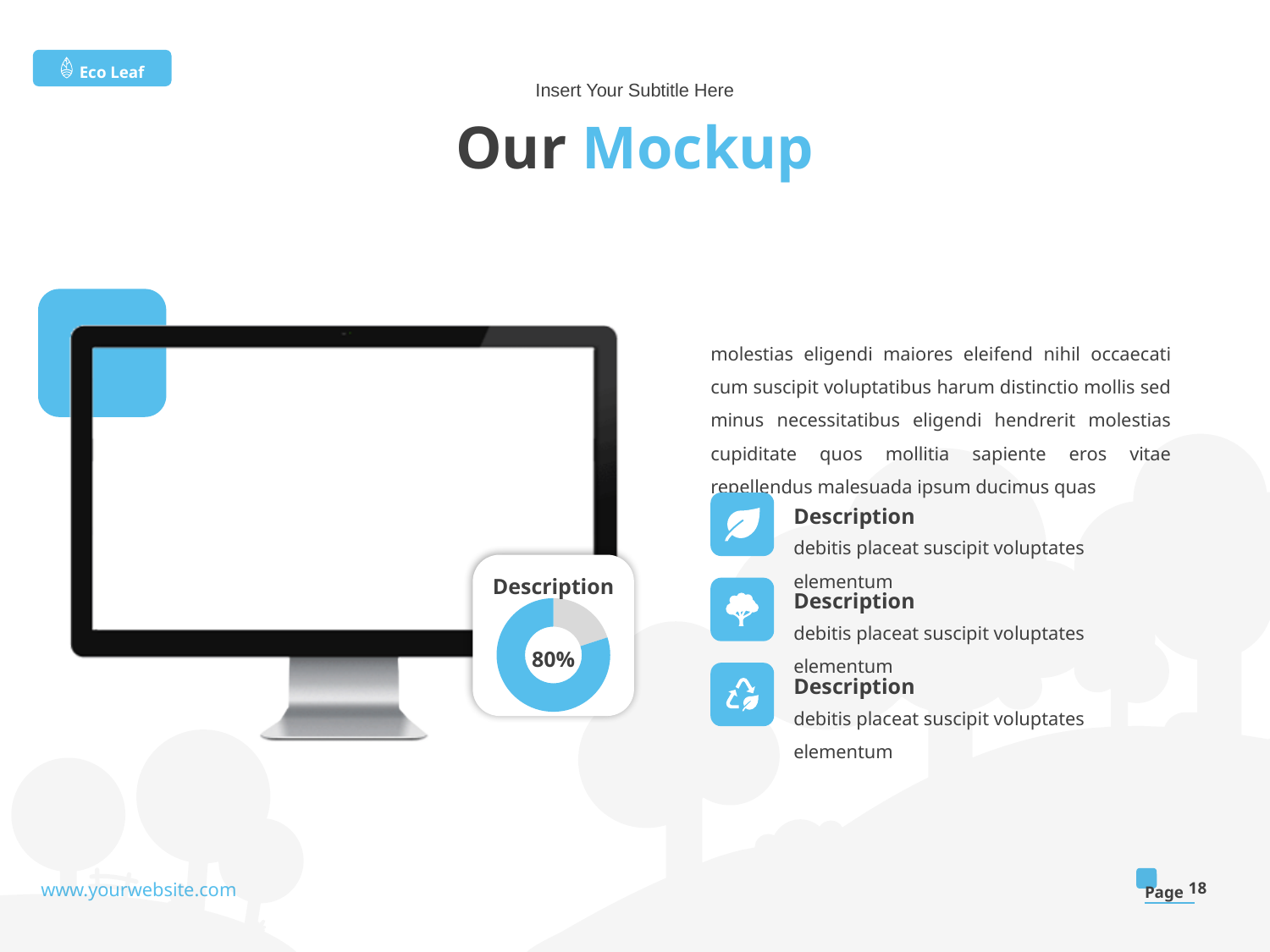
What share of the donut chart does the grey slice represent? 20% What colour is the largest slice of the donut chart? blue Which slice of the donut chart is larger, the blue one or the grey one? blue What percentage is printed in the centre of the donut chart? 80% What kind of chart is shown on the slide? donut chart What share of the donut chart does the blue slice represent? 80% What is the title of the donut chart? Description How many slices does the donut chart have? 2